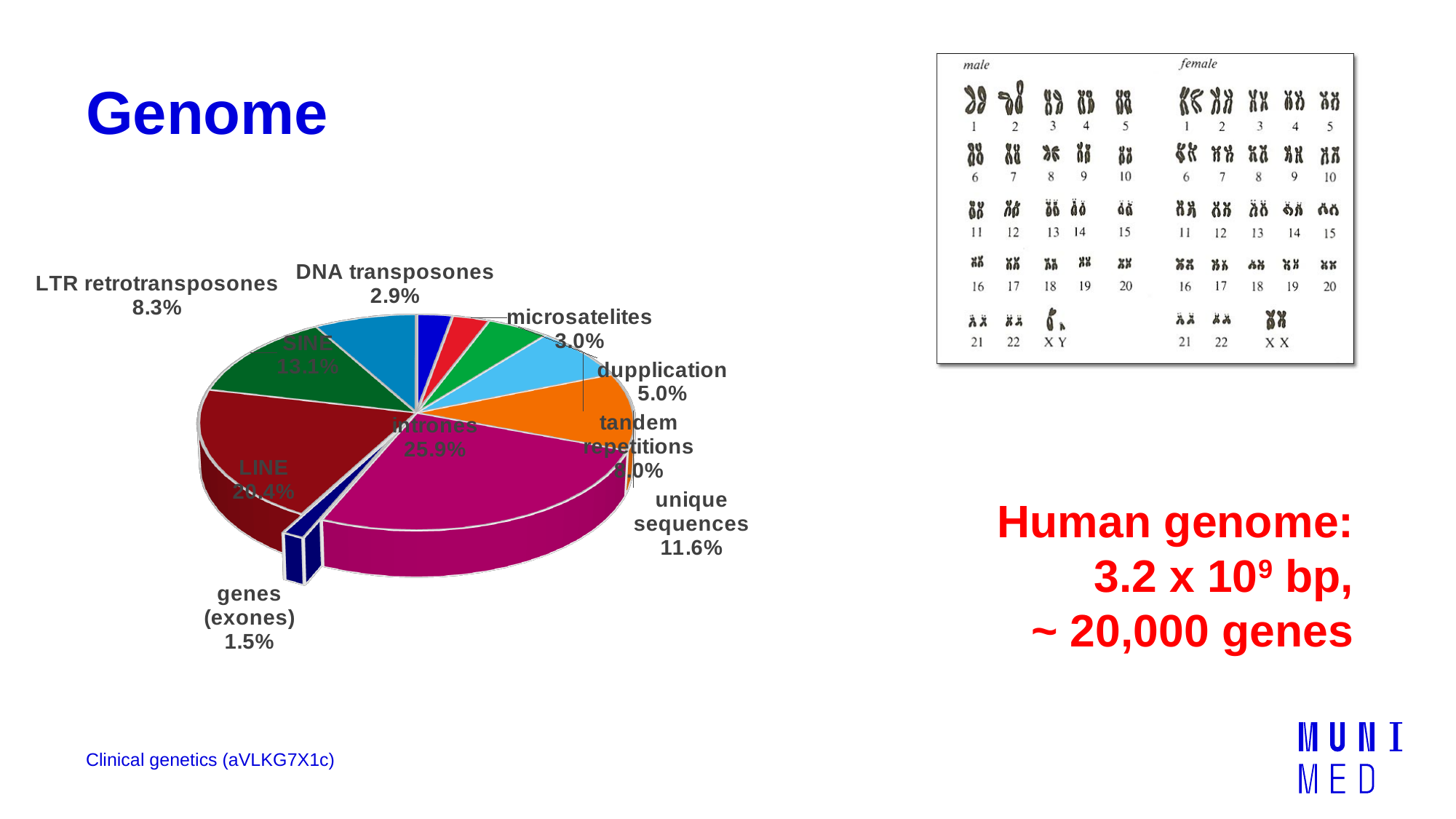
Which category has the largest share of the pie? intrones How many categories (slices) does the pie chart have? 10 What percentage is shown for DNA transposones? 2.9% What percentage is shown for genes (exones)? 1.5% What kind of chart is shown on the slide? pie chart What percentage is shown for microsatelites? 3.0% Which slice is pulled out (exploded) from the pie? genes (exones) What percentage is shown for unique sequences? 11.6% What percentage of the genome is shown for LTR retrotransposones? 8.3% What is the difference in percentage points between LINE and SINE? 7.3 Which has a larger share, dupplication or microsatelites? dupplication Which category has the smallest share of the pie? genes (exones)